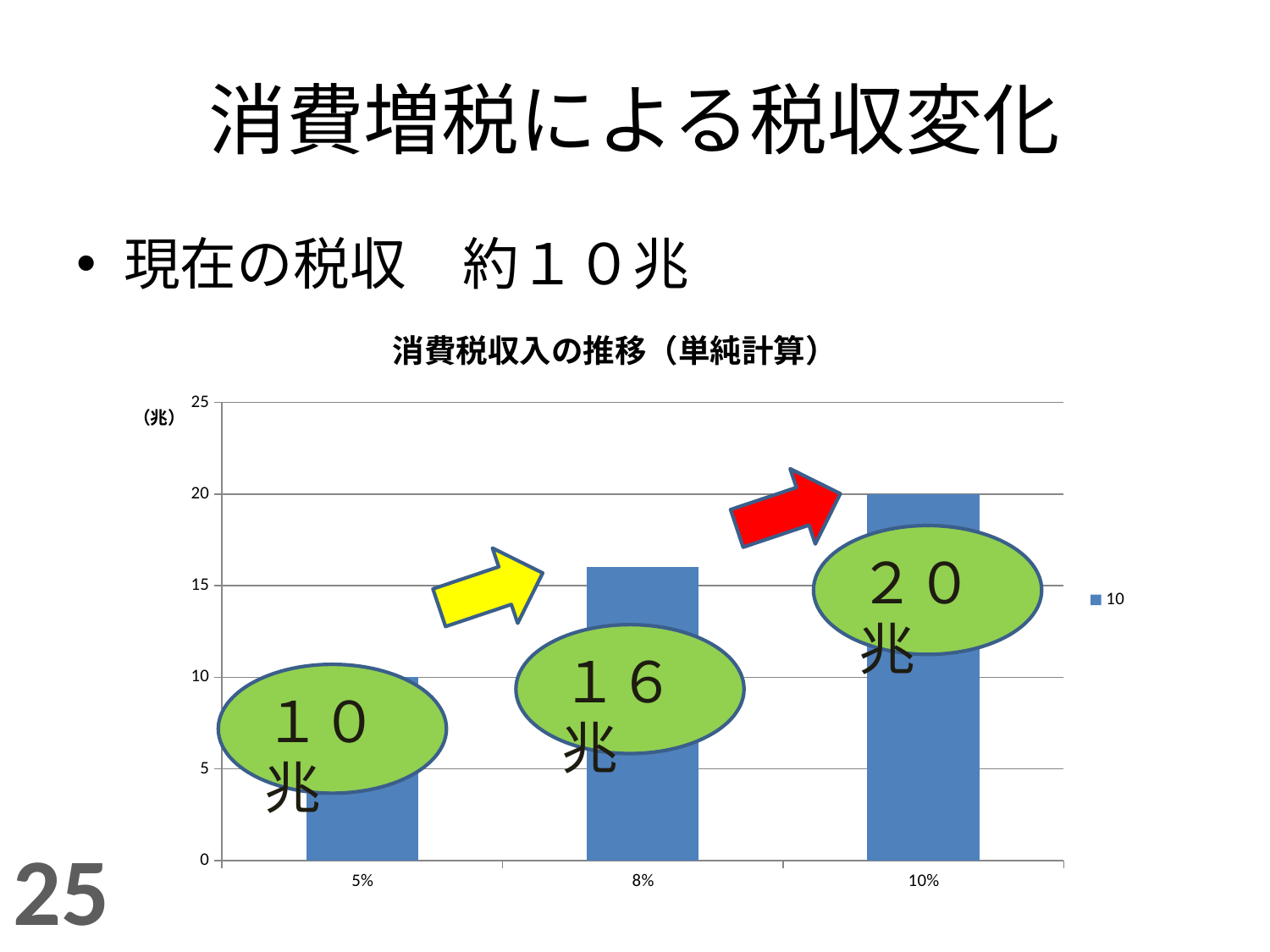
How many bars (categories) are plotted in the chart? 3 What is the value for the 10% category? ２０兆 What type of chart is shown on the slide? bar chart What is the title of the chart? 消費税収入の推移（単純計算） What is the value for the 5% category? １０兆 Which is larger, the value for 8% or the value for 10%? 10% Which category has the lowest value? 5% Which category has the highest value? 10% Do the values rise or fall from left to right along the x axis? rise What is the difference between the values for 8% and 5%? ６兆 What is the difference between the values for 10% and 5%? １０兆 What is the value for the 8% category? １６兆